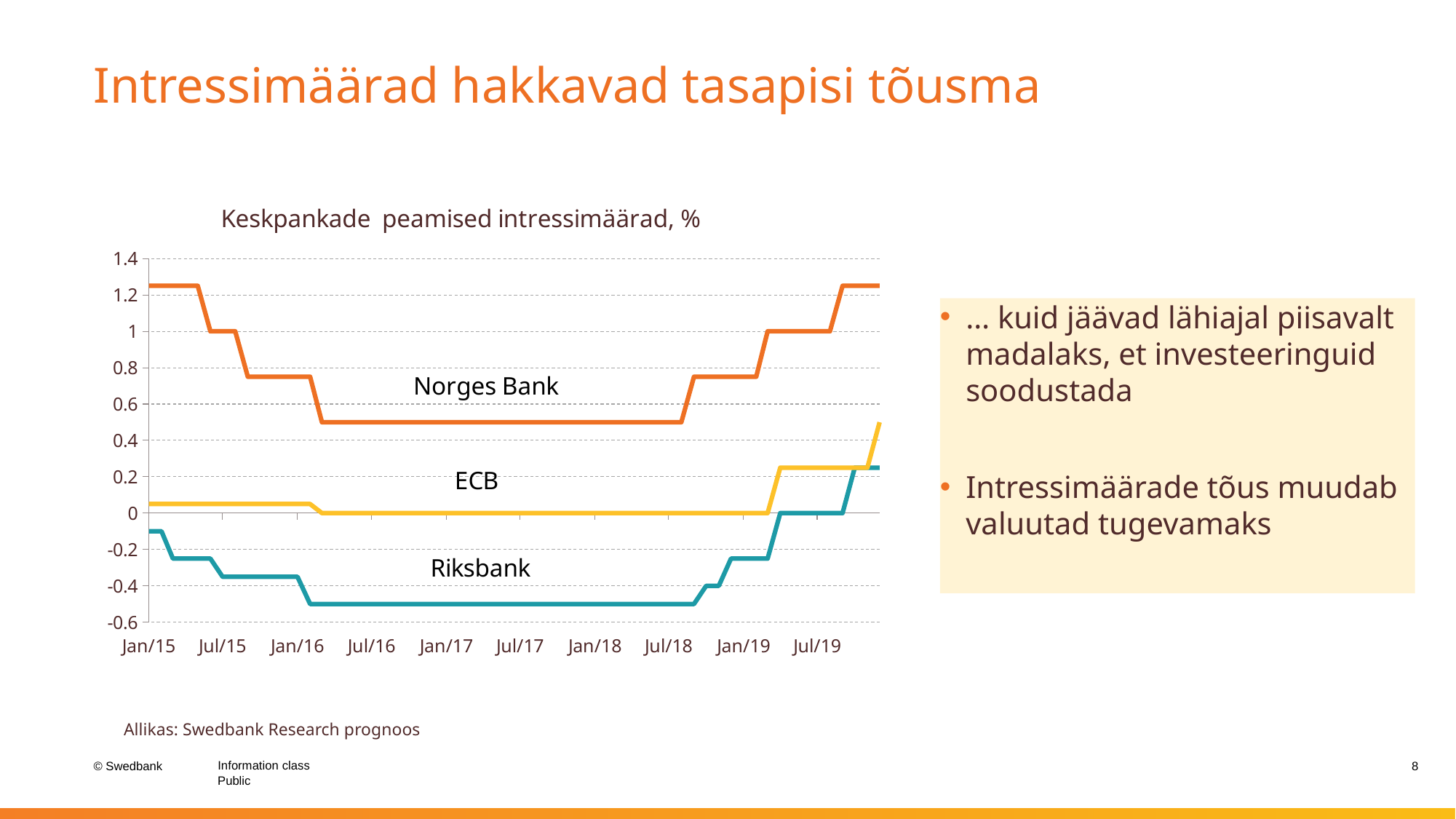
What kind of chart is shown on the slide? Line chart Is the Riksbank rate at Jan/17 greater or less than -0.4? less Is the Norges Bank rate at Jan/15 greater or less than 1? greater What is the ECB rate at Jan/17? 0 Which series has the highest interest rate throughout the whole period? Norges Bank Does the Norges Bank rate rise or fall between Jan/15 and Jan/17? Fall Which series has the lowest interest rate at Jan/15? Riksbank At Jan/16, which is higher: the ECB rate or the Riksbank rate? ECB Is the Norges Bank rate at Jan/17 greater or less than 0.6? less What is the Norges Bank rate at Jul/15? 1 What is the title of the chart? Keskpankade peamised intressimäärad, % How many central bank series are plotted in the chart? 3